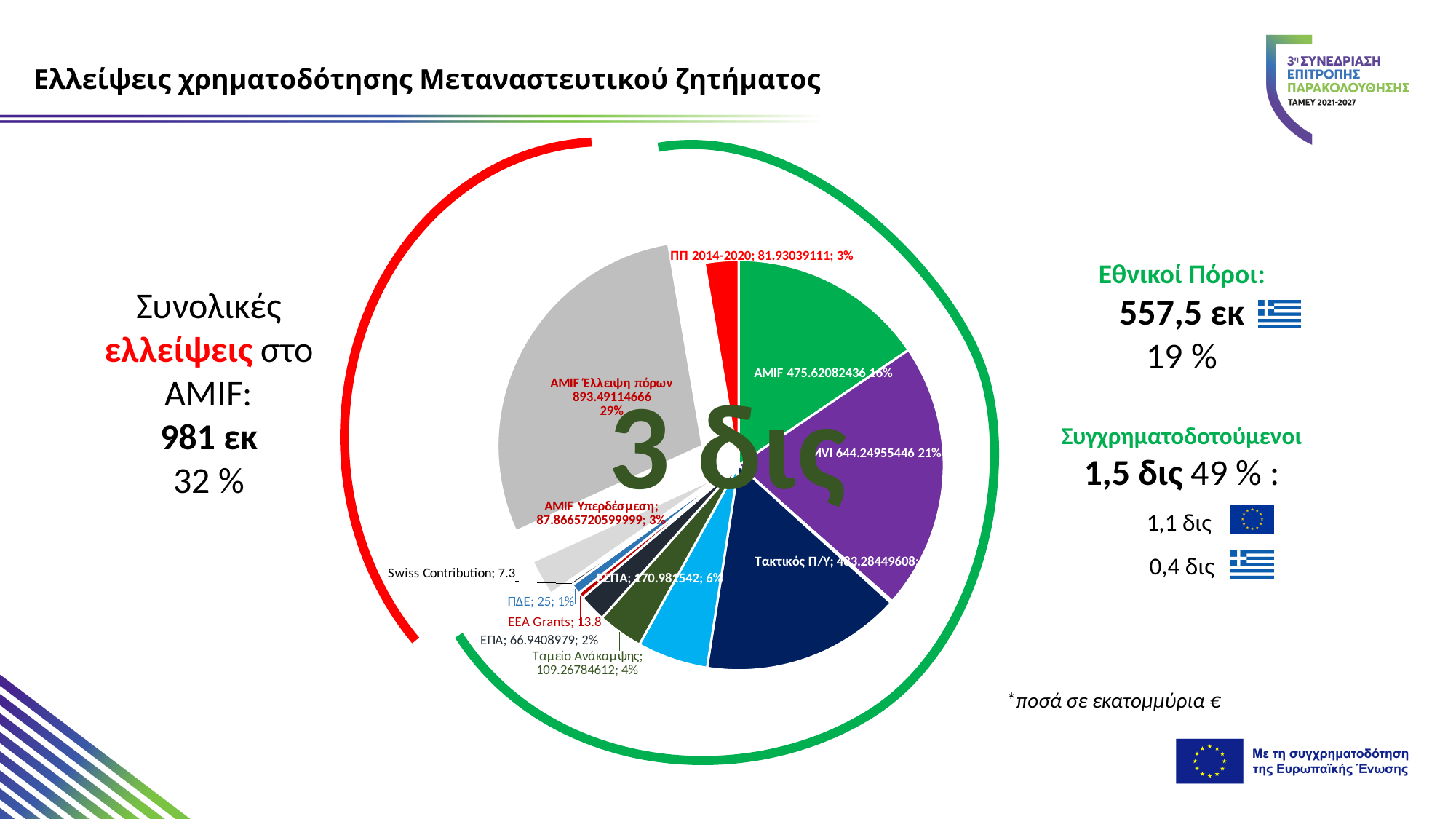
What text is printed in the centre of the pie chart? 3 δις What value is shown for the ΠΠ 2014-2020 slice of the pie chart? 81.93039111 Which is larger in the pie chart, ΕΣΠΑ or Ταμείο Ανάκαμψης? ΕΣΠΑ What value is shown for the Ταμείο Ανάκαμψης slice of the pie chart? 109.26784612 Which slice of the pie chart has the largest value? AMIF Έλλειψη πόρων What share of the pie does the AMIF Έλλειψη πόρων slice represent? 29% What kind of chart is shown on the slide? pie chart What value is shown for the Swiss Contribution slice of the pie chart? 7.3 What is the difference between the ΠΔΕ value and the EEA Grants value in the pie chart? 11.2 What is the difference between the ΠΔΕ value and the Swiss Contribution value in the pie chart? 17.7 What value is shown for the ΕΣΠΑ slice of the pie chart? 170.981542